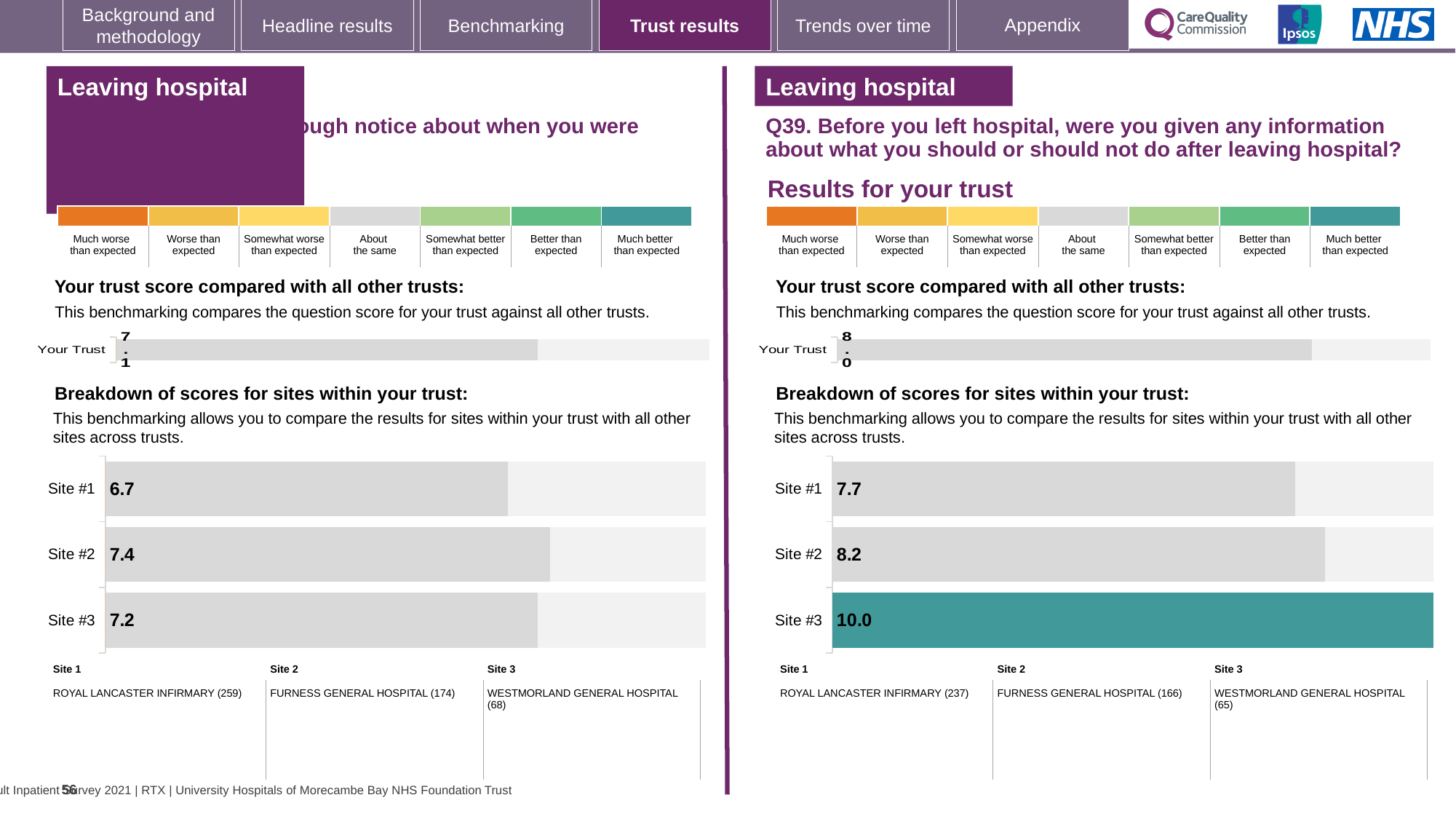
On the left-hand site breakdown chart, which site has the lowest score? Site #1 On the left-hand site breakdown chart, which is larger, the score for Site #2 or Site #3? Site #2 On the left-hand site breakdown chart, what is the score for Site #2? 7.4 On the left-hand 'Your Trust' bar chart, what is the trust score shown? 7.1 How many sites are shown on the right-hand (Q39) site breakdown chart? 3 On the right-hand (Q39) site breakdown chart, what is the score for Site #3? 10.0 On the right-hand (Q39) 'Your Trust' bar chart, what is the trust score shown? 8.0 On the left-hand site breakdown chart, what is the score for Site #1? 6.7 On the right-hand (Q39) site breakdown chart, which site has the highest score? Site #3 On the right-hand (Q39) site breakdown chart, what is the score for Site #1? 7.7 What type of chart is used for the site breakdown on the left-hand side of the slide? Bar chart On the right-hand (Q39) site breakdown chart, what is the difference between the scores for Site #3 and Site #1? 2.3